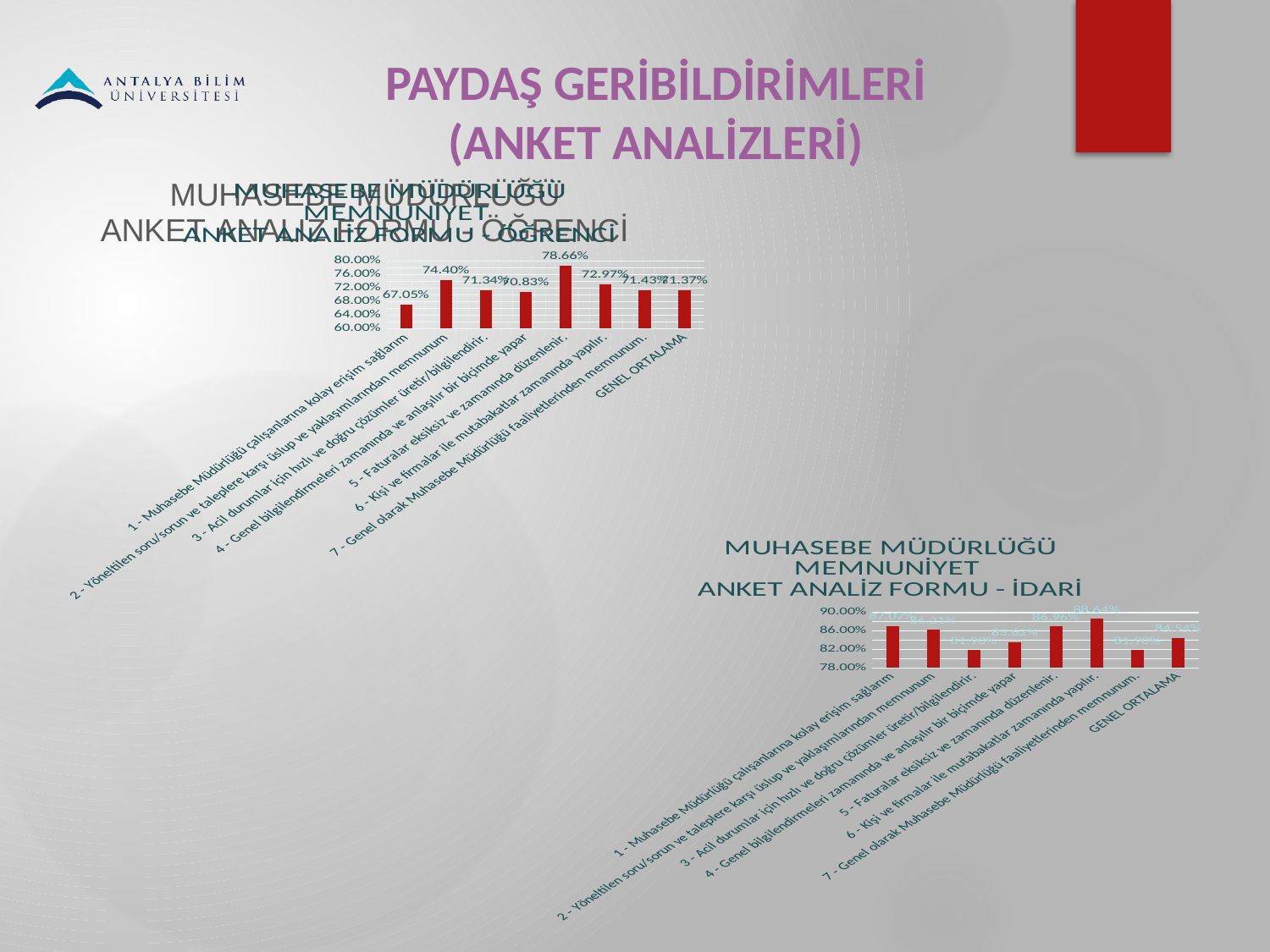
In the top-left chart (ÖĞRENCİ), which is larger: the value for item 2 (74.40%) or the value for item 6 (72.97%)? Item 2 (74.40%) In the top-left chart (ÖĞRENCİ), which category has the lowest value? 1 - Muhasebe Müdürlüğü çalışanlarına kolay erişim sağlarım In the top-left chart (ÖĞRENCİ), what is the value for '1 - Muhasebe Müdürlüğü çalışanlarına kolay erişim sağlarım'? 67.05% What is the title of the bottom-right chart? MUHASEBE MÜDÜRLÜĞÜ MEMNUNİYET ANKET ANALİZ FORMU - İDARİ In the top-left chart (ÖĞRENCİ), how many bars are plotted? 8 In the bottom-right chart (İDARİ), is the value for '4 - Genel bilgilendirmeleri zamanında ve anlaşılır bir biçimde yapar' greater or less than 86.00%? less In the bottom-right chart (İDARİ), is the value for '6 - Kişi ve firmalar ile mutabakatlar zamanında yapılır.' greater or less than 86.00%? greater In the top-left chart (ÖĞRENCİ), which category has the highest value? 5 - Faturalar eksiksiz ve zamanında düzenlenir. In the top-left chart (ÖĞRENCİ), what is the value for 'GENEL ORTALAMA'? 71.37% In the top-left chart (ÖĞRENCİ), what is the value for '5 - Faturalar eksiksiz ve zamanında düzenlenir.'? 78.66% What kind of chart is the bottom-right chart (İDARİ)? Bar chart In the top-left chart (ÖĞRENCİ), what is the difference between the highest value (78.66%) and the lowest value (67.05%)? 11.61%